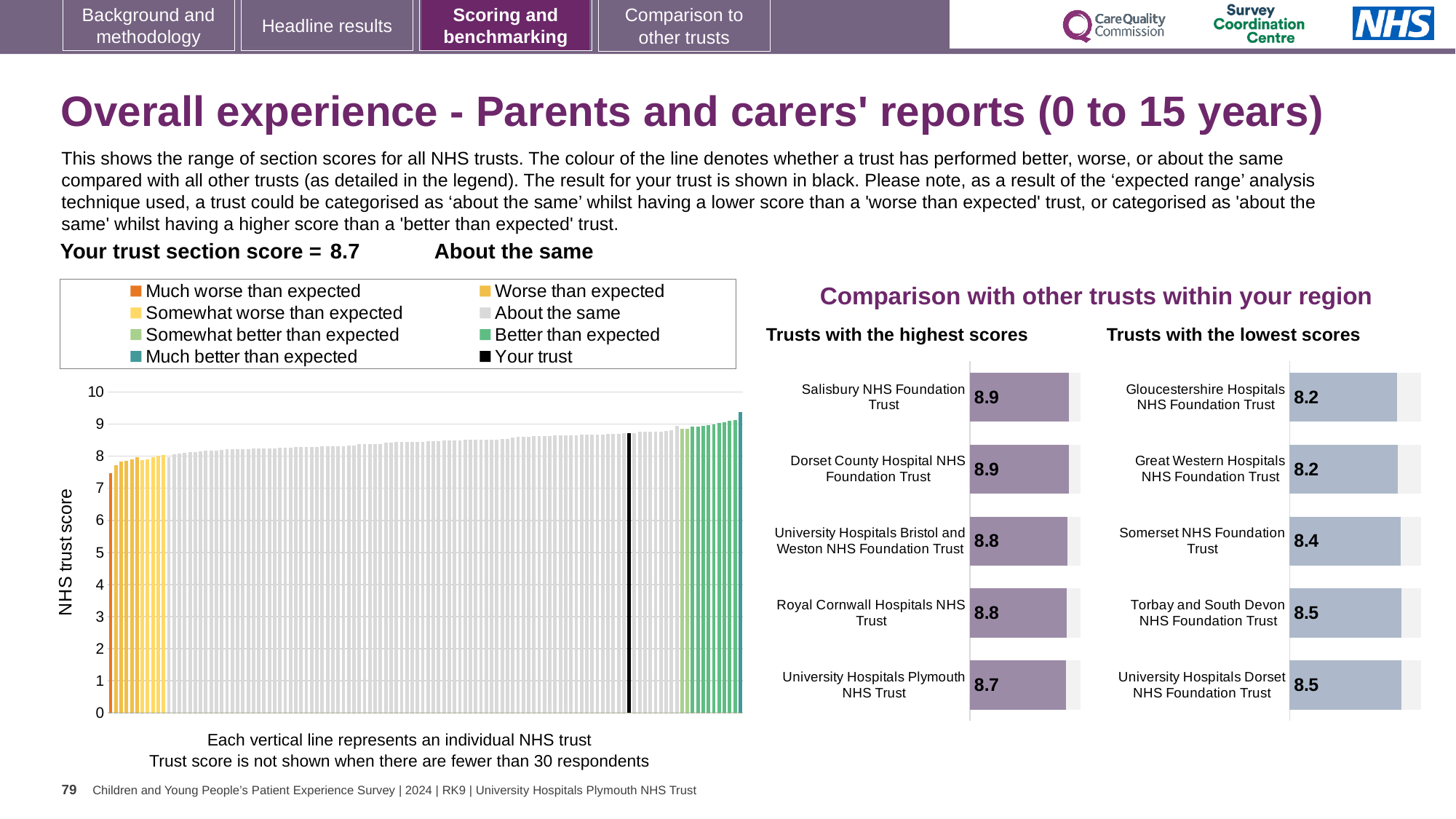
In the 'Trusts with the lowest scores' chart, what is the difference between the scores of Somerset NHS Foundation Trust and Great Western Hospitals NHS Foundation Trust? 0.2 In the 'Trusts with the lowest scores' chart, what is the score for Gloucestershire Hospitals NHS Foundation Trust? 8.2 In the large chart on the left, do the trust scores rise or fall from left to right? Rise What kind of chart is the large chart on the left with the 'NHS trust score' axis? Bar chart In the 'Trusts with the highest scores' chart, what is the score for Salisbury NHS Foundation Trust? 8.9 In the 'Trusts with the highest scores' chart, what is the difference between the scores of Salisbury NHS Foundation Trust and University Hospitals Plymouth NHS Trust? 0.2 In the 'Trusts with the highest scores' chart, which trust has the lowest score? University Hospitals Plymouth NHS Trust In the 'Trusts with the lowest scores' chart, which has the larger score: Somerset NHS Foundation Trust or Torbay and South Devon NHS Foundation Trust? Torbay and South Devon NHS Foundation Trust In the 'Trusts with the lowest scores' chart, what is the score for Somerset NHS Foundation Trust? 8.4 In the 'Trusts with the highest scores' chart, what is the score for University Hospitals Plymouth NHS Trust? 8.7 How many entries does the legend of the large chart on the left list? 8 How many trusts are shown in the 'Trusts with the highest scores' chart? 5